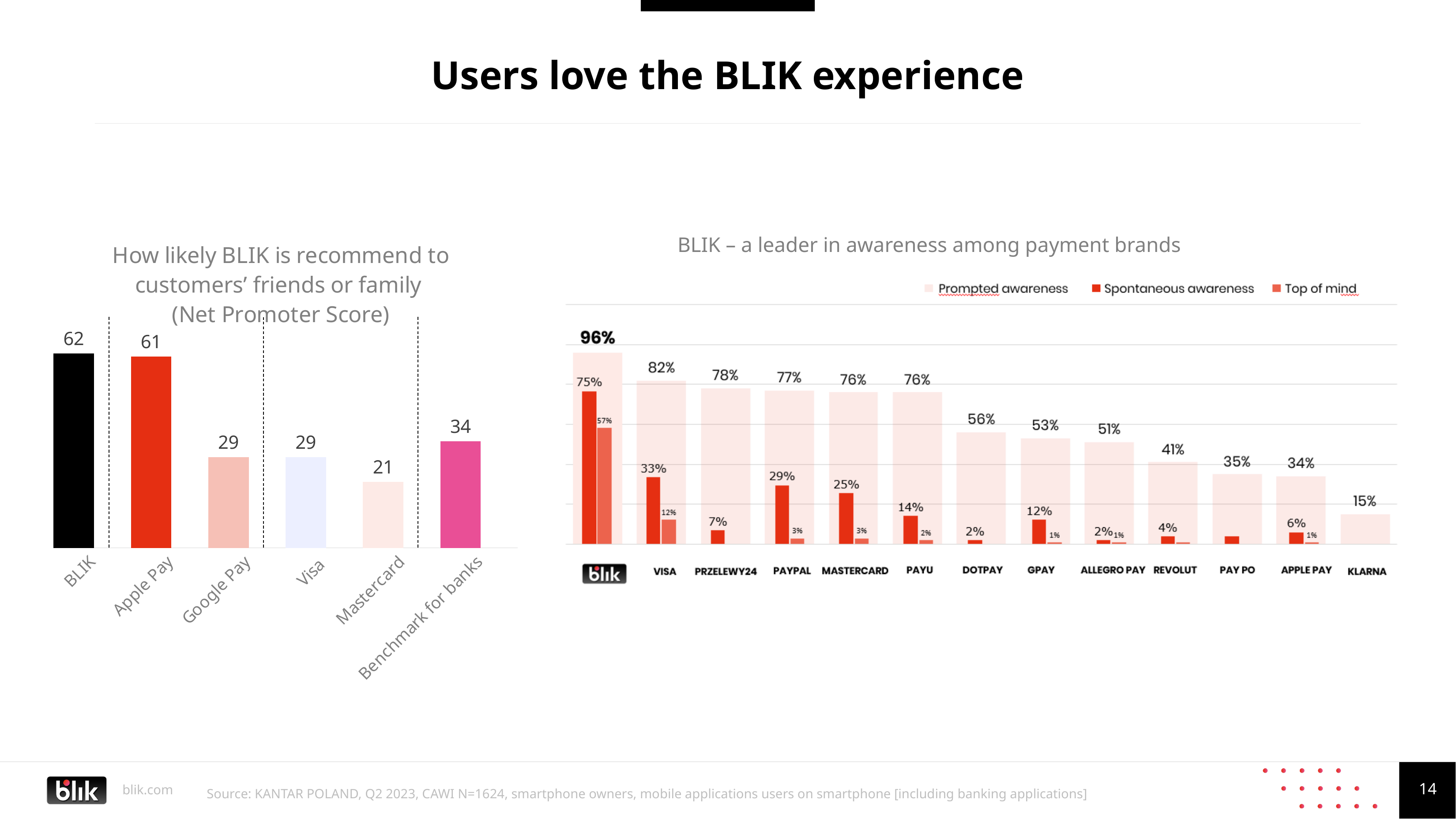
In the awareness chart on the right, which brand has the lowest prompted awareness? Klarna In the Net Promoter Score chart on the left, what is the value for Mastercard? 21 In the Net Promoter Score chart on the left, which is larger, the value for Benchmark for banks or the value for Visa? Benchmark for banks In the Net Promoter Score chart on the left, which category has the lowest value? Mastercard In the awareness chart on the right, how many series does the legend list? 3 In the Net Promoter Score chart on the left, what is the difference between Apple Pay and Google Pay? 32 What kind of chart is the awareness chart on the right? Bar chart In the awareness chart on the right, what is the spontaneous awareness for PayPal? 29% In the awareness chart on the right, what is the prompted awareness for Visa? 82% In the Net Promoter Score chart on the left, what is the value for BLIK? 62 In the awareness chart on the right, what is the top of mind value for BLIK? 57% In the Net Promoter Score chart on the left, how many categories are shown? 6